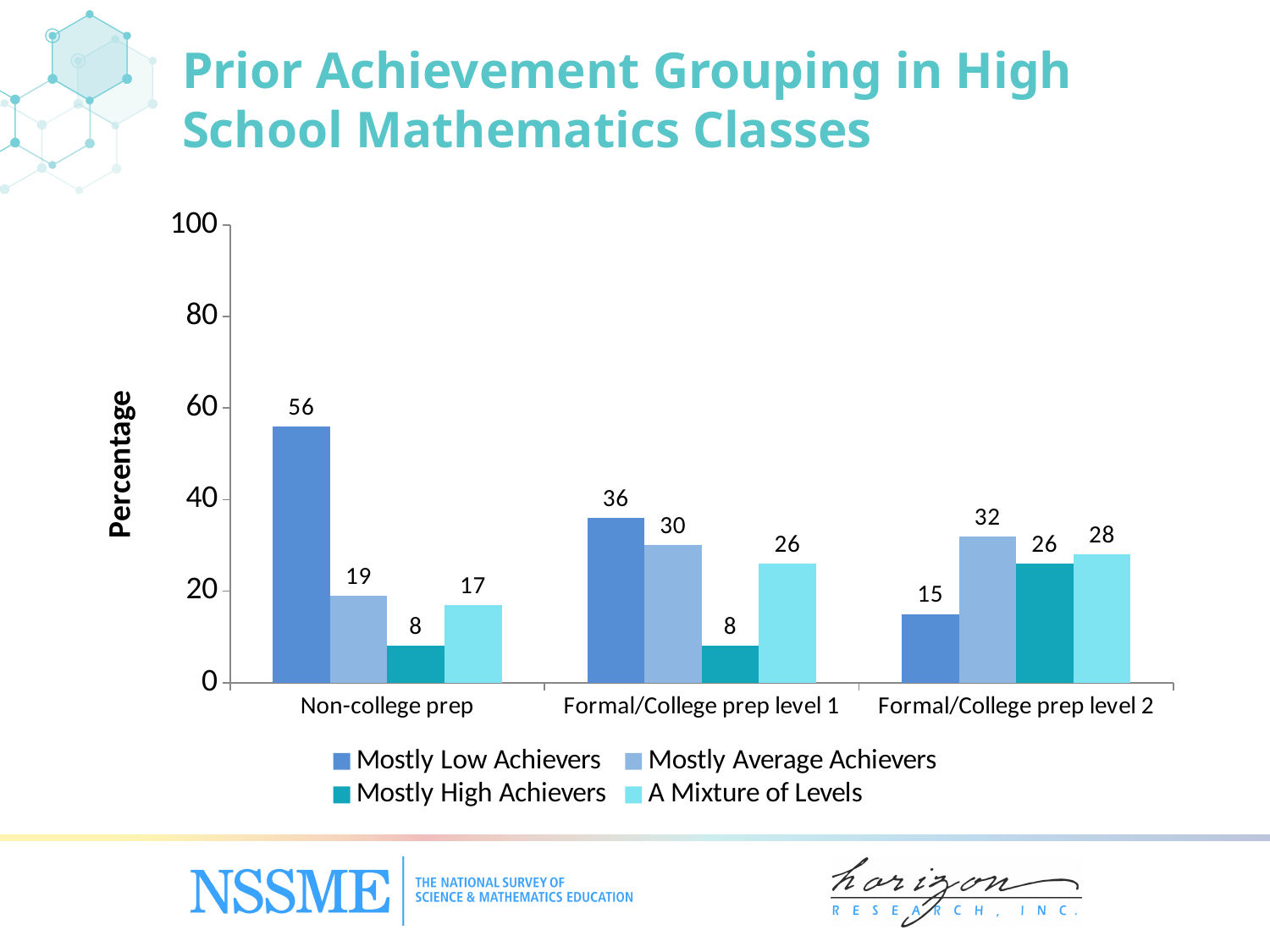
What is the difference between the Mostly Low Achievers values for Non-college prep and Formal/College prep level 1? 20 Which is larger in Formal/College prep level 2: Mostly Average Achievers or Mostly High Achievers? Mostly Average Achievers Do the Mostly Low Achievers values rise or fall from Non-college prep to Formal/College prep level 2? fall How many class categories are shown on the x axis? 3 Is the value for Mostly Low Achievers in Non-college prep greater or less than 40? greater What is the value for Mostly High Achievers in Formal/College prep level 1 classes? 8 Which category has the lowest value for Mostly Low Achievers? Formal/College prep level 2 What kind of chart is shown on the slide? bar chart What is the value for A Mixture of Levels in Formal/College prep level 2 classes? 28 How many series does the legend list? 4 Which category has the highest value for Mostly Average Achievers? Formal/College prep level 2 What percentage of Non-college prep classes are Mostly Low Achievers? 56